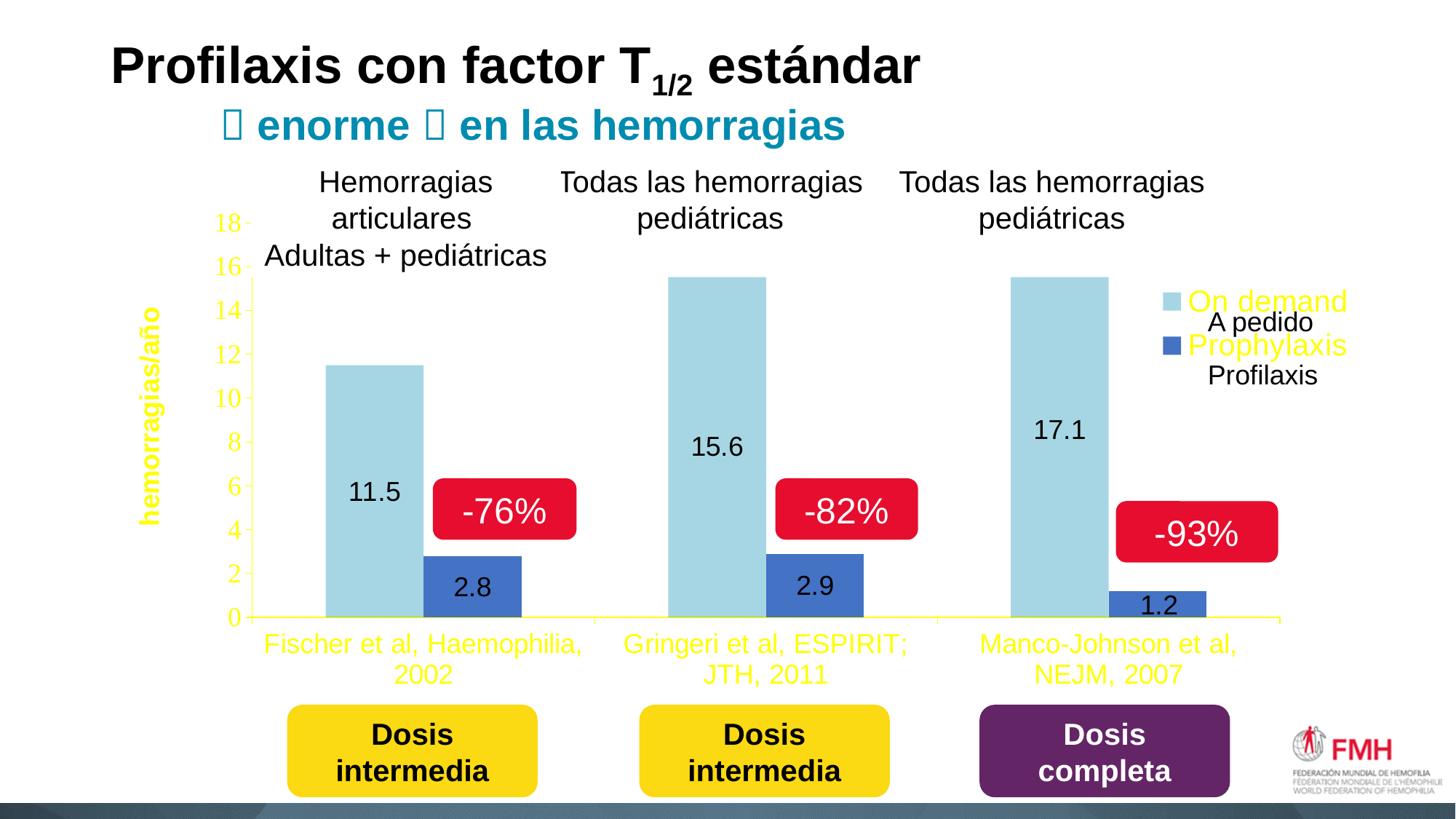
What is the On demand value for Manco-Johnson et al, NEJM, 2007? 17.1 What is the On demand value for Fischer et al, Haemophilia, 2002? 11.5 Which study has the lowest Prophylaxis value? Manco-Johnson et al, NEJM, 2007 What is the label of the y axis? hemorragias/año What is the Prophylaxis value for Gringeri et al, ESPIRIT; JTH, 2011? 2.9 What is the difference between the On demand and Prophylaxis values for Fischer et al, Haemophilia, 2002? 8.7 What is the Prophylaxis value for Manco-Johnson et al, NEJM, 2007? 1.2 What type of chart is shown on the slide? bar chart How many study categories are shown along the x axis? 3 Which is larger for Gringeri et al, ESPIRIT; JTH, 2011: the On demand value or the Prophylaxis value? On demand How many series does the legend list? 2 What percentage reduction is shown in the red box for Manco-Johnson et al, NEJM, 2007? -93%